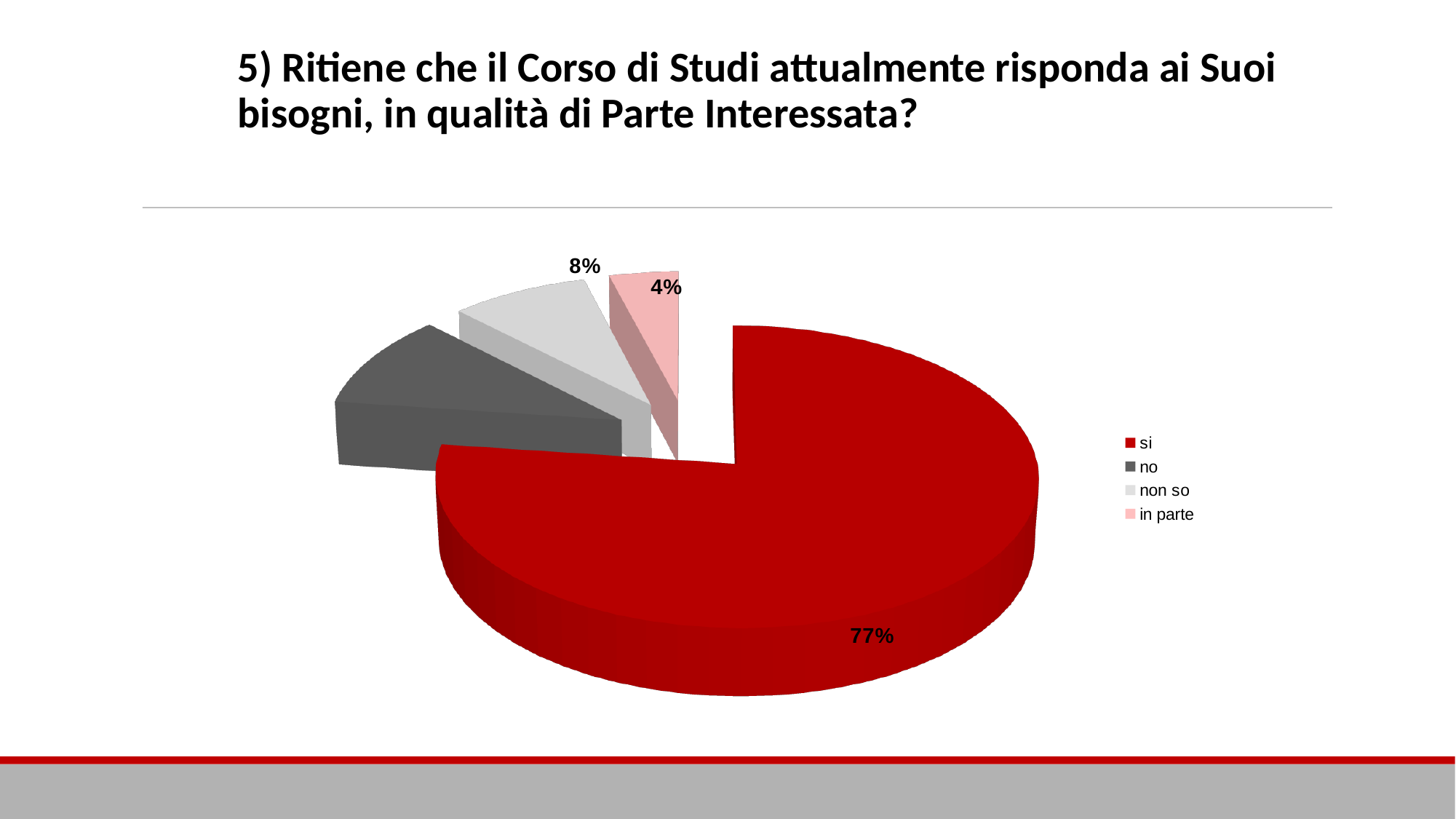
Which legend entry is shown in dark grey? no What percentage of respondents answered "si"? 77% Which response has the smallest share of the pie? in parte What percentage of respondents answered "non so"? 8% Which response has the largest share of the pie? si How many categories does the legend list? 4 Which is larger, the share for "no" or the share for "in parte"? no What kind of chart is shown on the slide? pie chart Which is larger, the share for "non so" or the share for "in parte"? non so What is the difference in percentage points between "si" and "non so"? 69 What percentage of respondents answered "in parte"? 4% What colour is the "si" slice of the pie? red